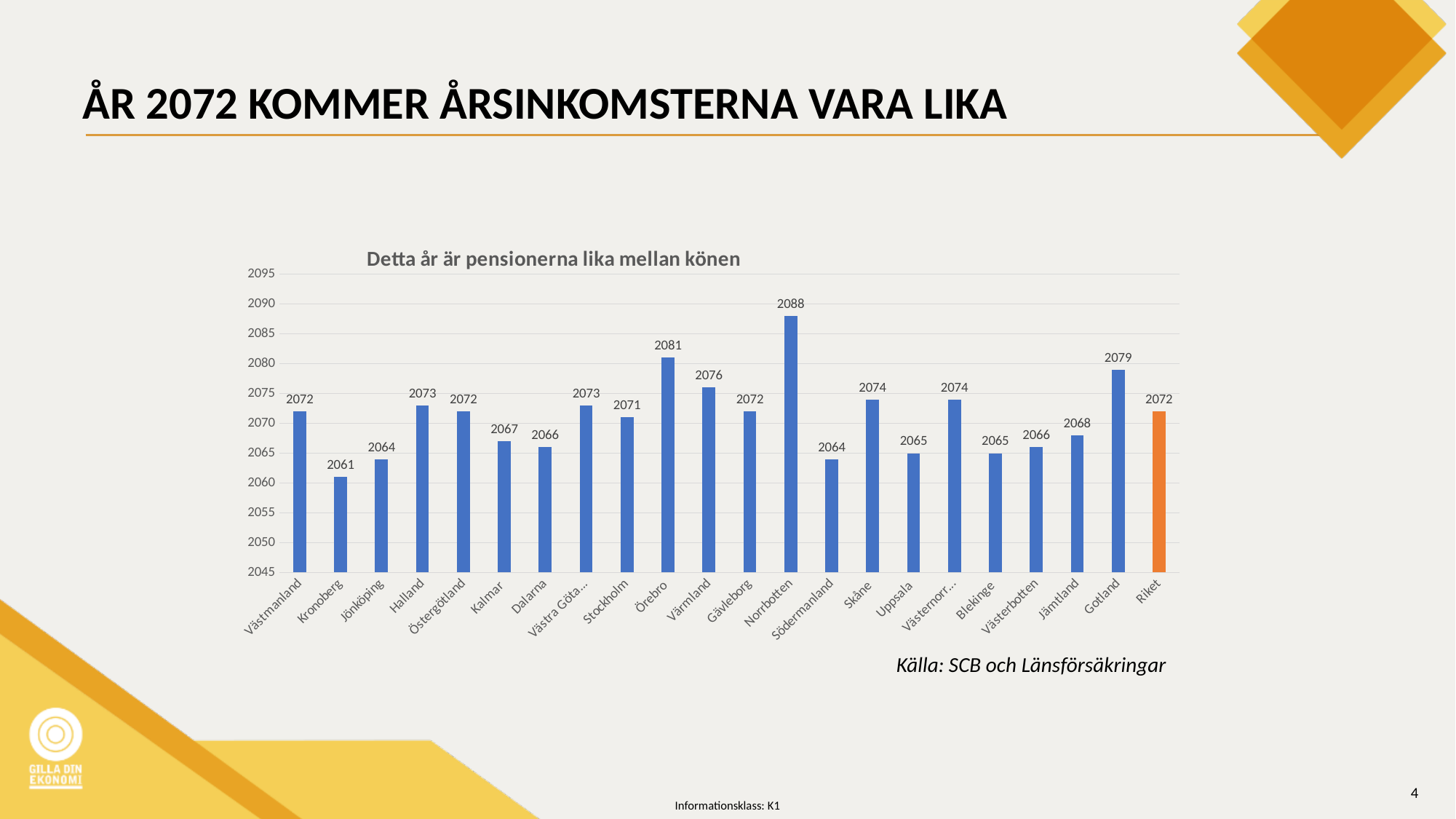
Which category has the lowest value? Kronoberg What is the difference between the values for Örebro and Stockholm? 10 What is the value for Norrbotten? 2088 What is the difference between the values for Norrbotten and Kronoberg? 27 What kind of chart is shown on the slide? Bar chart What is the title of the chart? Detta år är pensionerna lika mellan könen What is the value for Kronoberg? 2061 Which category has the highest value? Norrbotten What is the value for Riket? 2072 What is the value for Gotland? 2079 Which is larger, the value for Värmland or the value for Jämtland? Värmland How many categories are shown on the x axis? 22